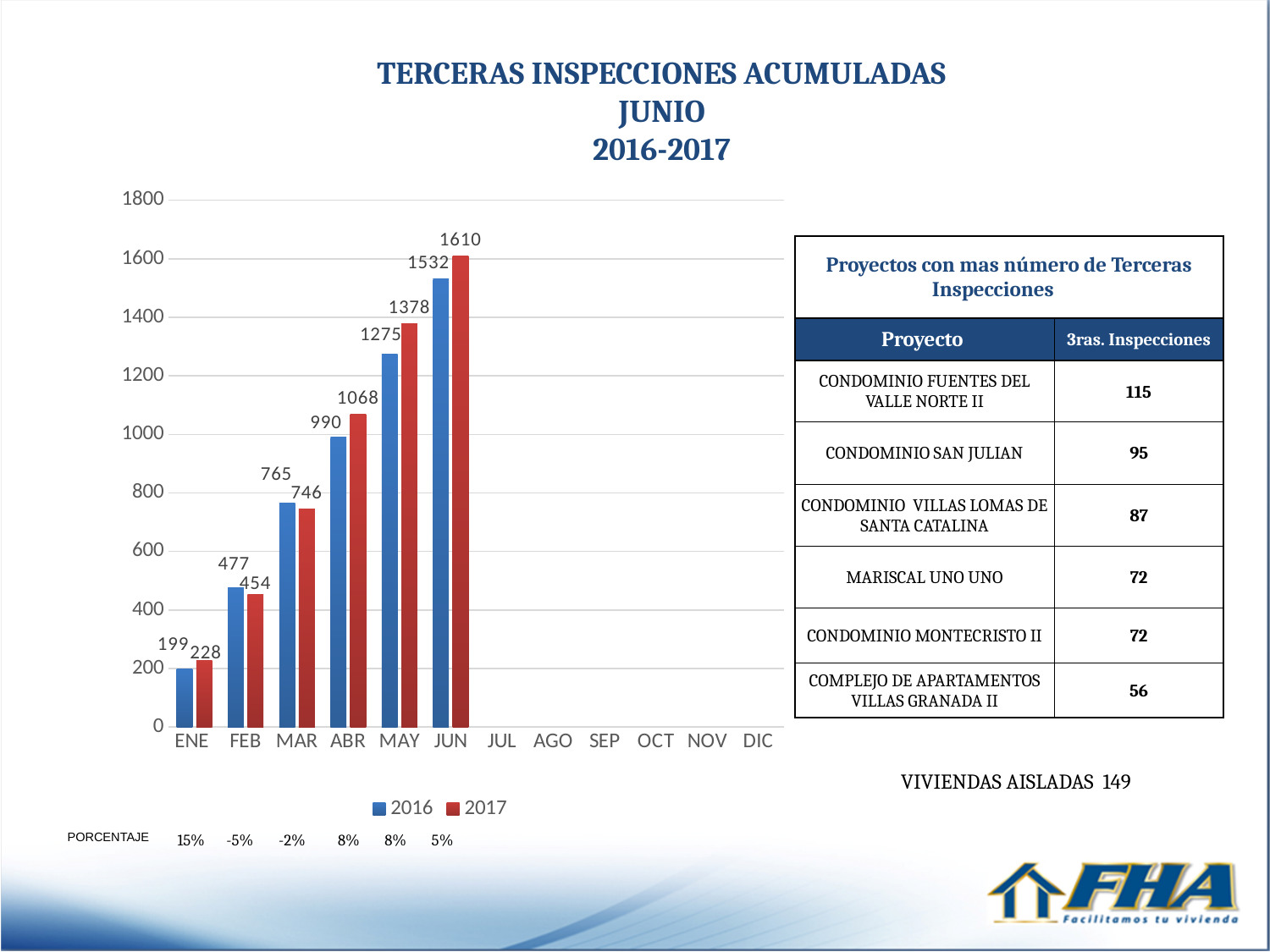
Which month has the lowest value for the 2017 series? ENE Do the 2017 values rise or fall from ENE to JUN? rise What is the difference between the 2017 and 2016 values in MAY? 103 How many series does the legend list? 2 Is the value for 2016 in MAR greater or less than 800? less What is the value for 2017 in JUN? 1610 What is the value for 2017 in ENE? 228 Which month has the highest value for the 2016 series? JUN What is the value for 2016 in ABR? 990 Which is larger in FEB, the 2016 value or the 2017 value? 2016 How many month categories are shown on the x axis? 12 What kind of chart is shown on the slide? bar chart